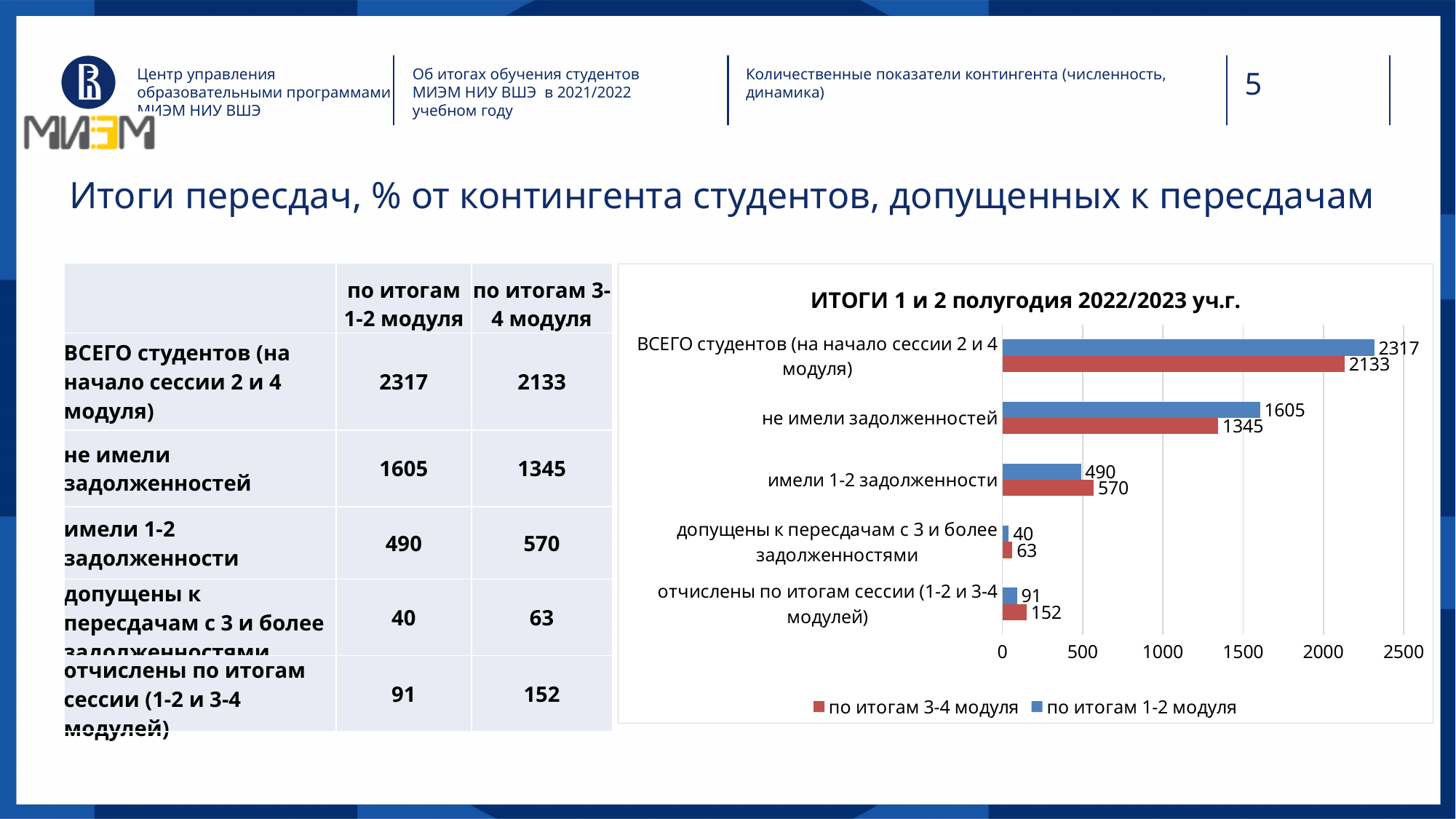
Which category has the lowest value in the 'по итогам 1-2 модуля' series? допущены к пересдачам с 3 и более задолженностями What is the title of the chart? ИТОГИ 1 и 2 полугодия 2022/2023 уч.г. What is the difference between the 'по итогам 1-2 модуля' and 'по итогам 3-4 модуля' values for 'не имели задолженностей'? 260 Is the 'по итогам 3-4 модуля' value for 'не имели задолженностей' greater or less than 1500? less For 'имели 1-2 задолженности', which series has the larger value: 'по итогам 1-2 модуля' or 'по итогам 3-4 модуля'? по итогам 3-4 модуля What kind of chart is shown on the slide? bar chart What is the value for 'отчислены по итогам сессии (1-2 и 3-4 модулей)' in the 'по итогам 3-4 модуля' series? 152 What is the value for 'не имели задолженностей' in the 'по итогам 1-2 модуля' series? 1605 What is the value for 'допущены к пересдачам с 3 и более задолженностями' in the 'по итогам 1-2 модуля' series? 40 How many series does the chart legend list? 2 How many categories are shown on the chart? 5 Which category has the highest value in the 'по итогам 3-4 модуля' series? ВСЕГО студентов (на начало сессии 2 и 4 модуля)